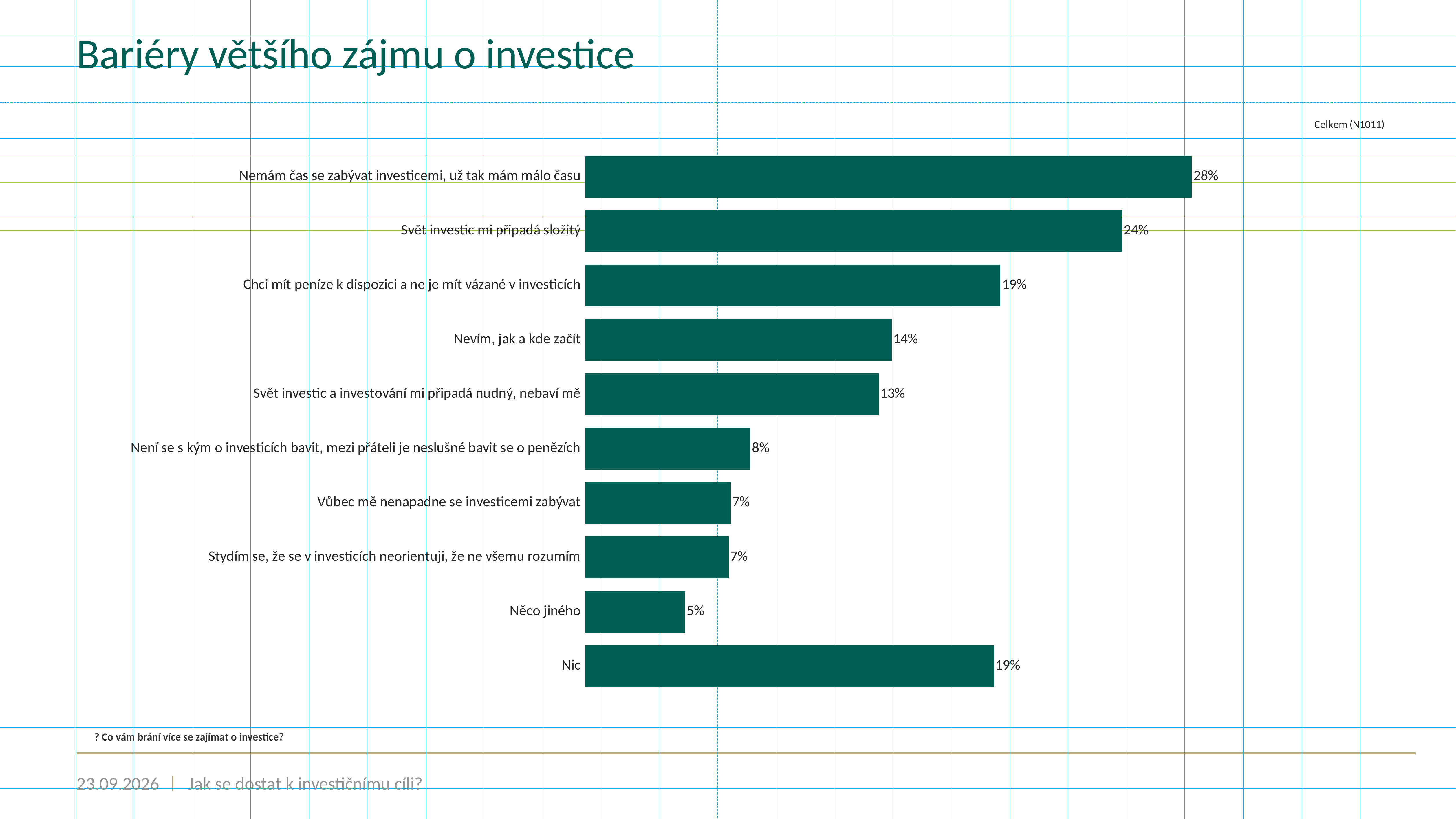
What is the value for "Nevím, jak a kde začít"? 14% Which category has the highest value? Nemám čas se zabývat investicemi, už tak mám málo času Which category has the lowest value? Něco jiného How many categories are shown in the chart? 10 What is the value for "Něco jiného"? 5% What is the value for "Nemám čas se zabývat investicemi, už tak mám málo času"? 28% What kind of chart is shown on the slide? Bar chart Which is larger: the value for "Svět investic a investování mi připadá nudný, nebaví mě" or the value for "Není se s kým o investicích bavit, mezi přáteli je neslušné bavit se o penězích"? Svět investic a investování mi připadá nudný, nebaví mě What is the legend entry shown above the chart? Celkem (N1011) What is the value for "Svět investic mi připadá složitý"? 24% What is the value for "Nic"? 19% What is the difference between the values for "Svět investic mi připadá složitý" and "Nevím, jak a kde začít"? 10%